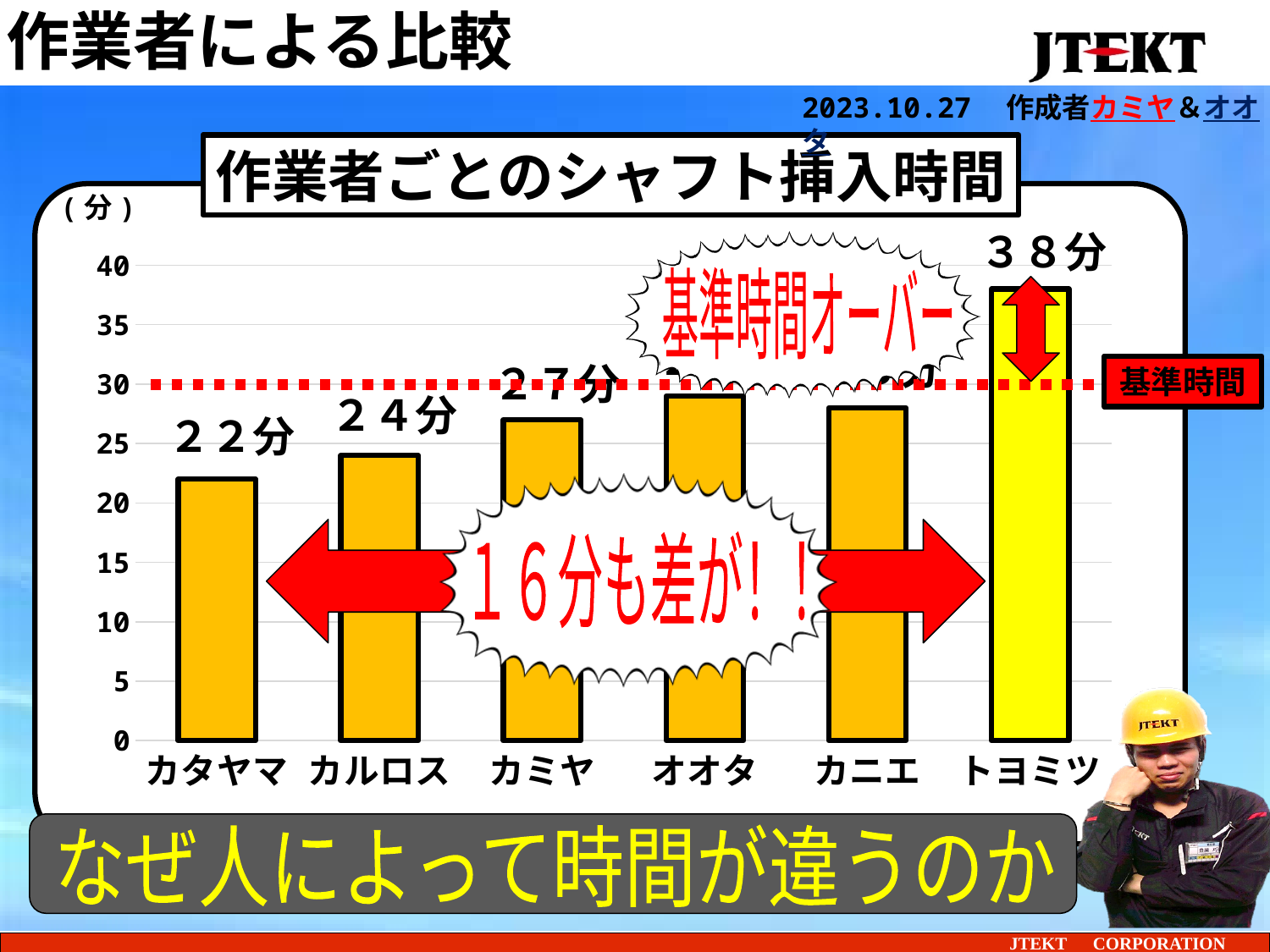
What is the difference between the values for トヨミツ and カタヤマ? 16分 What is the value for カミヤ? 27分 What is the value for カタヤマ? 22分 What is the value for トヨミツ? 38分 What kind of chart is shown on the slide? bar chart How many workers are shown on the x axis? 6 What is the value for カルロス? 24分 Is the value for オオタ greater or less than 30? less Which worker has the lowest shaft insertion time? カタヤマ Which is larger, the value for カルロス or the value for カミヤ? カミヤ Is the value for カニエ greater or less than 25? greater Which worker has the highest shaft insertion time? トヨミツ